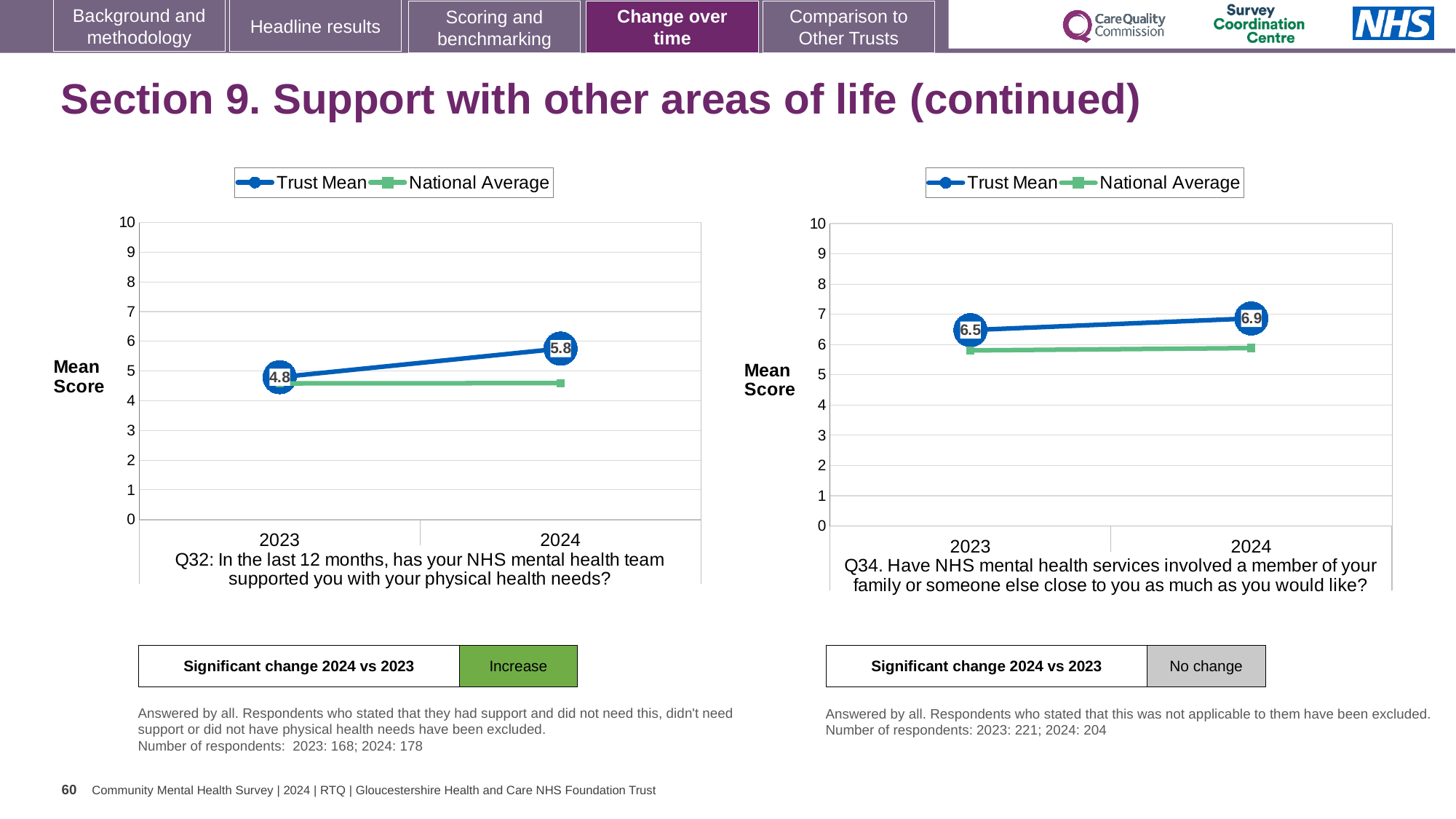
In the Q32 chart (left), does the Trust Mean rise or fall from 2023 to 2024? rise In the Q34 chart (right), what is the Trust Mean for 2023? 6.5 In the Q32 chart (left), by how much did the Trust Mean change from 2023 to 2024? 1.0 In the Q34 chart (right), what is the difference between the Trust Mean in 2024 and in 2023? 0.4 In the Q32 chart (left), what is the Trust Mean for 2023? 4.8 In the Q34 chart (right), is the National Average for 2024 greater or less than 7? less What kind of chart is the Q34 chart (right)? line chart In the Q32 chart (left), which is larger in 2024, the Trust Mean or the National Average? Trust Mean In the Q34 chart (right), what is the Trust Mean for 2024? 6.9 In the Q32 chart (left), what is the Trust Mean for 2024? 5.8 How many series does the legend of the Q32 chart (left) list? 2 How many years are plotted on the x axis of the Q34 chart (right)? 2